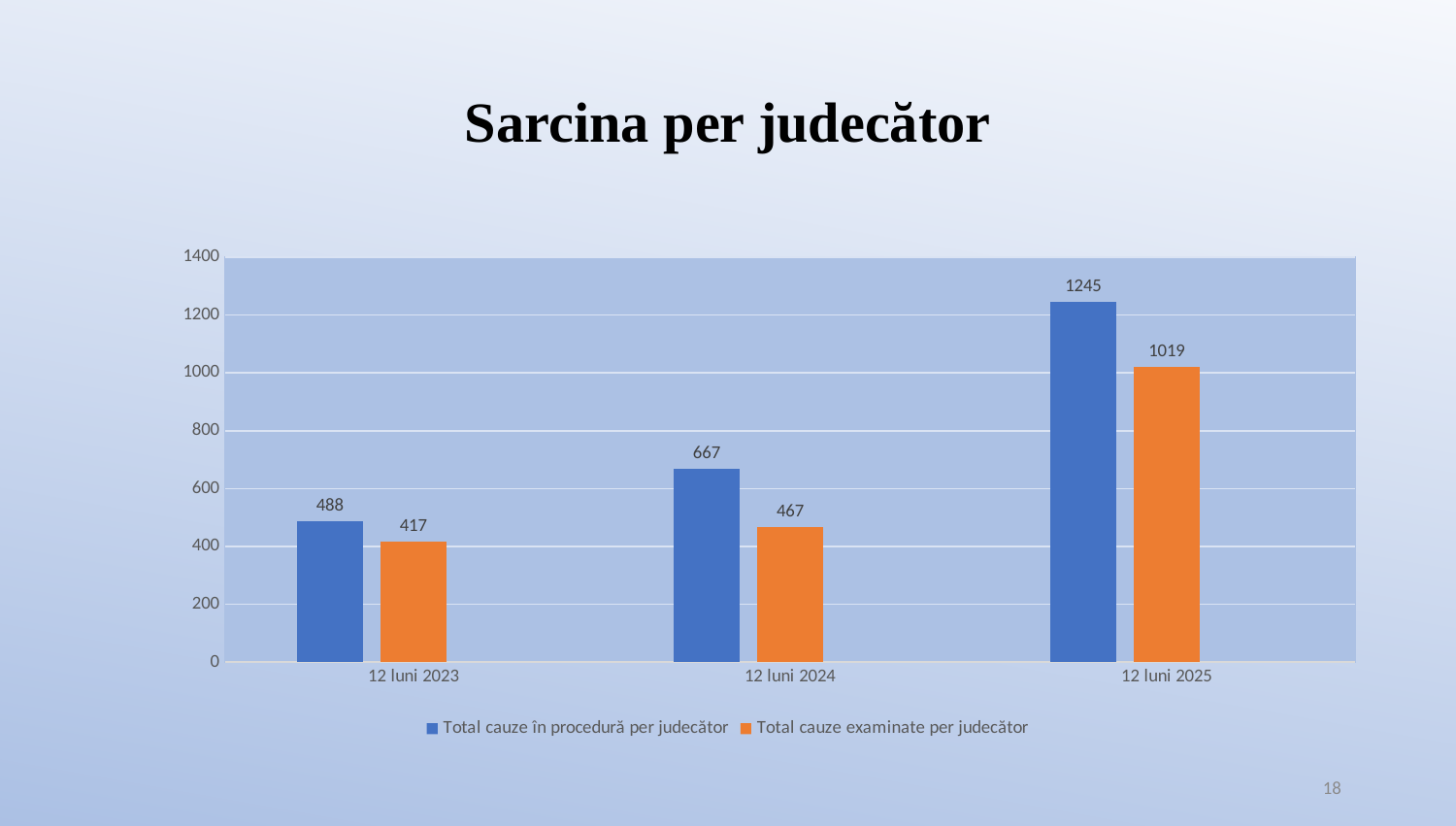
What is the difference in 'Total cauze în procedură per judecător' between 12 luni 2024 and 12 luni 2023? 179 Which is larger for 12 luni 2024: 'Total cauze în procedură per judecător' or 'Total cauze examinate per judecător'? Total cauze în procedură per judecător What is the value of 'Total cauze examinate per judecător' for 12 luni 2023? 417 How many series does the legend list? 2 Which period has the highest value for 'Total cauze în procedură per judecător'? 12 luni 2025 What is the value of 'Total cauze examinate per judecător' for 12 luni 2025? 1019 What is the difference between 'Total cauze în procedură per judecător' and 'Total cauze examinate per judecător' for 12 luni 2025? 226 Does 'Total cauze examinate per judecător' rise or fall from 12 luni 2023 to 12 luni 2025? Rise What kind of chart is shown on the slide? Bar chart What is the value of 'Total cauze în procedură per judecător' for 12 luni 2024? 667 How many periods are shown on the x axis? 3 Which period has the lowest value for 'Total cauze examinate per judecător'? 12 luni 2023